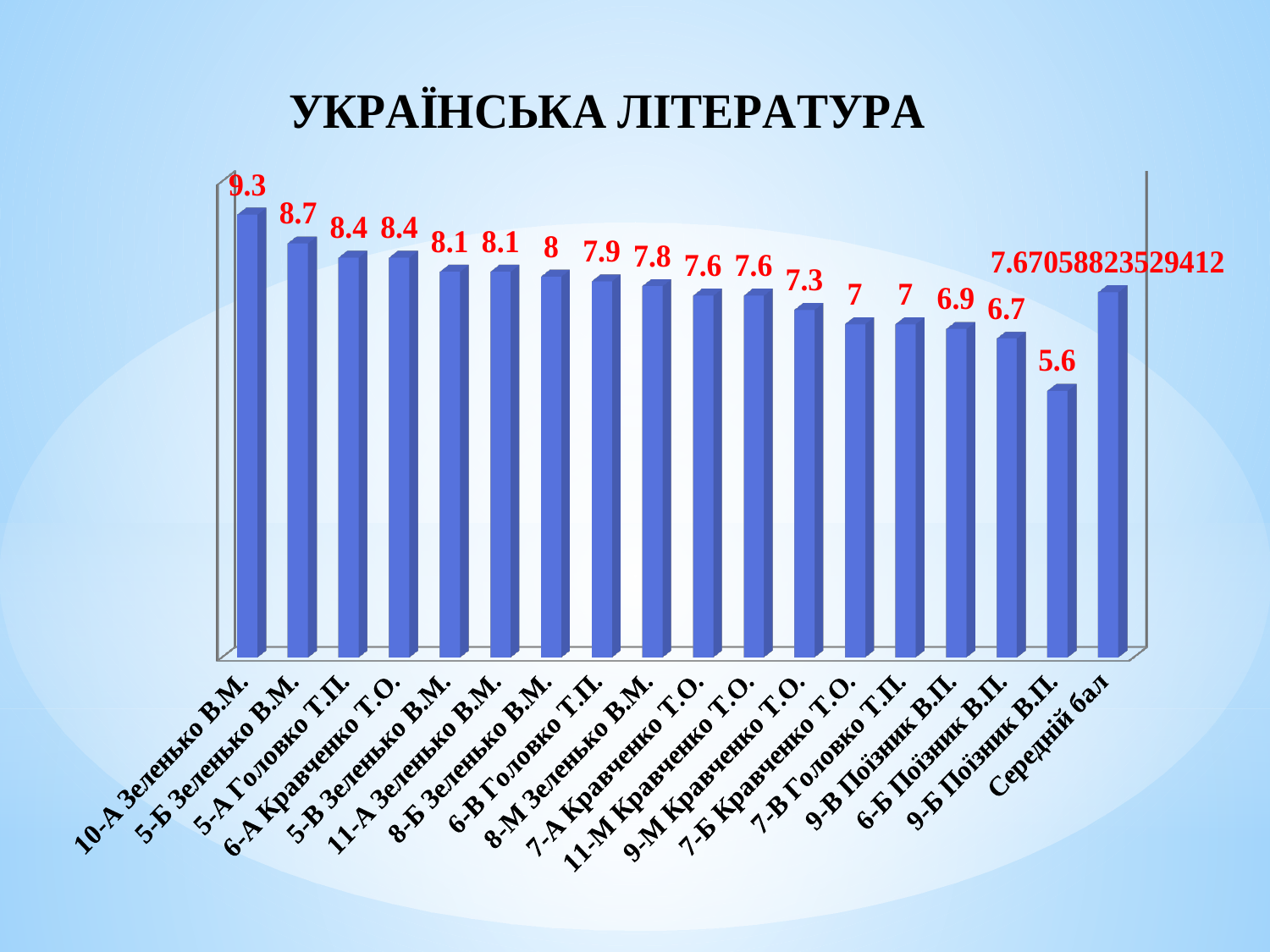
What kind of chart is shown on the slide? Bar chart Which category has the highest value? 10-А Зеленько В.М. What is the title of the chart? УКРАЇНСЬКА ЛІТЕРАТУРА What is the difference between the values for 10-А Зеленько В.М. and 9-Б Поізник В.П.? 3.7 Which category has the lowest value? 9-Б Поізник В.П. How many bars are shown in the chart? 18 What is the value for 9-М Кравченко Т.О.? 7.3 What is the value for 10-А Зеленько В.М.? 9.3 Which is larger, the value for 6-В Головко Т.П. or the value for 9-В Поізник В.П.? 6-В Головко Т.П. What is the difference between the values for 5-Б Зеленько В.М. and 6-Б Поізник В.П.? 2 What is the value shown for Середній бал? 7.67058823529412 What is the value for 9-Б Поізник В.П.? 5.6